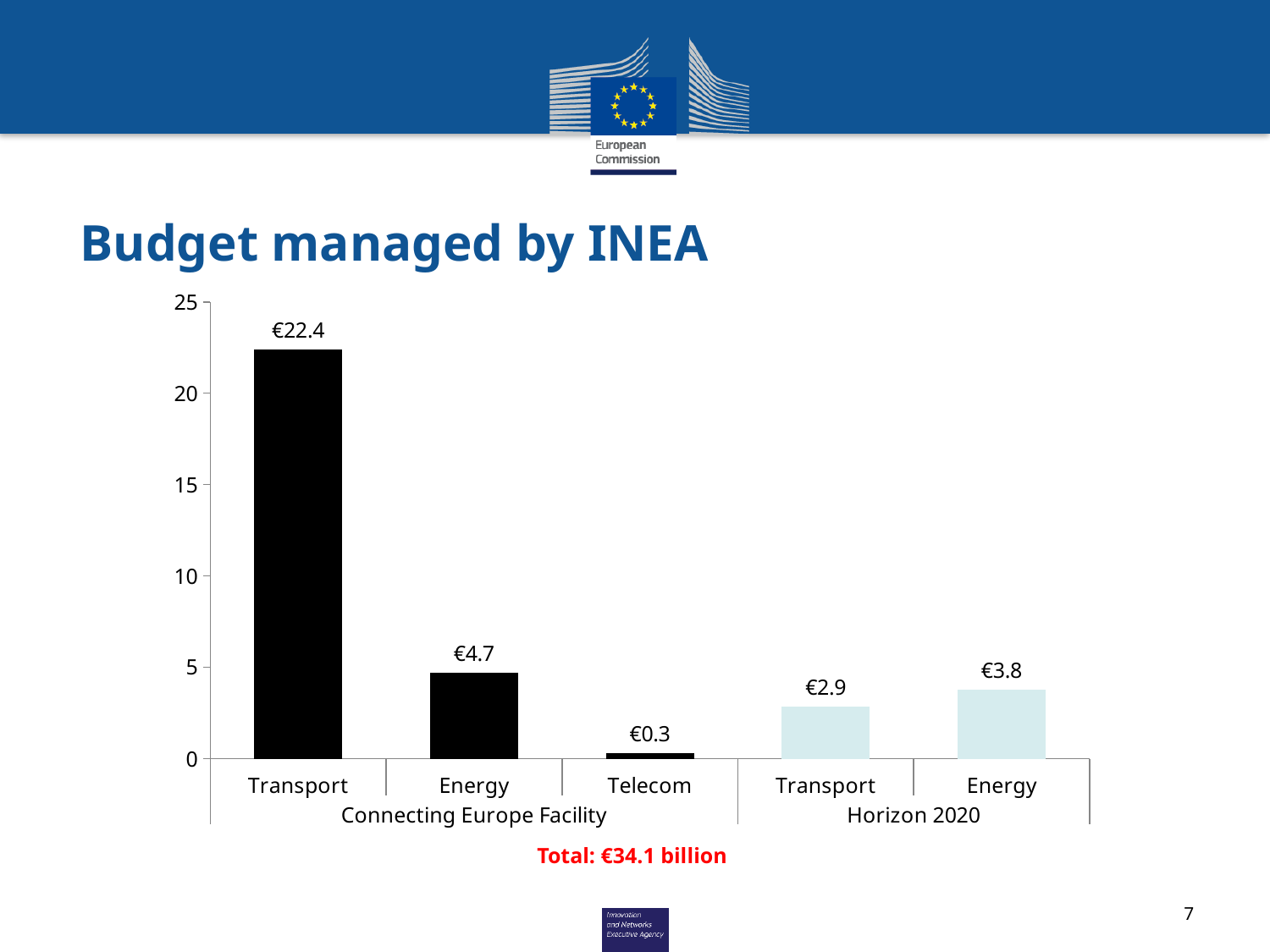
What is the title of the chart? Budget managed by INEA What is the value for Energy under Horizon 2020? €3.8 Is the value for Transport under Connecting Europe Facility greater or less than 20? greater Which bar has the lowest value? Telecom (Connecting Europe Facility) What is the value for Transport under Connecting Europe Facility? €22.4 What kind of chart is shown on the slide? bar chart What is the difference between Energy under Connecting Europe Facility and Energy under Horizon 2020? €0.9 What is the value for Telecom under Connecting Europe Facility? €0.3 What total is stated below the chart? €34.1 billion Which is larger: Transport under Horizon 2020 or Energy under Horizon 2020? Energy under Horizon 2020 How many bars are plotted in the chart? 5 Which bar has the highest value? Transport (Connecting Europe Facility)